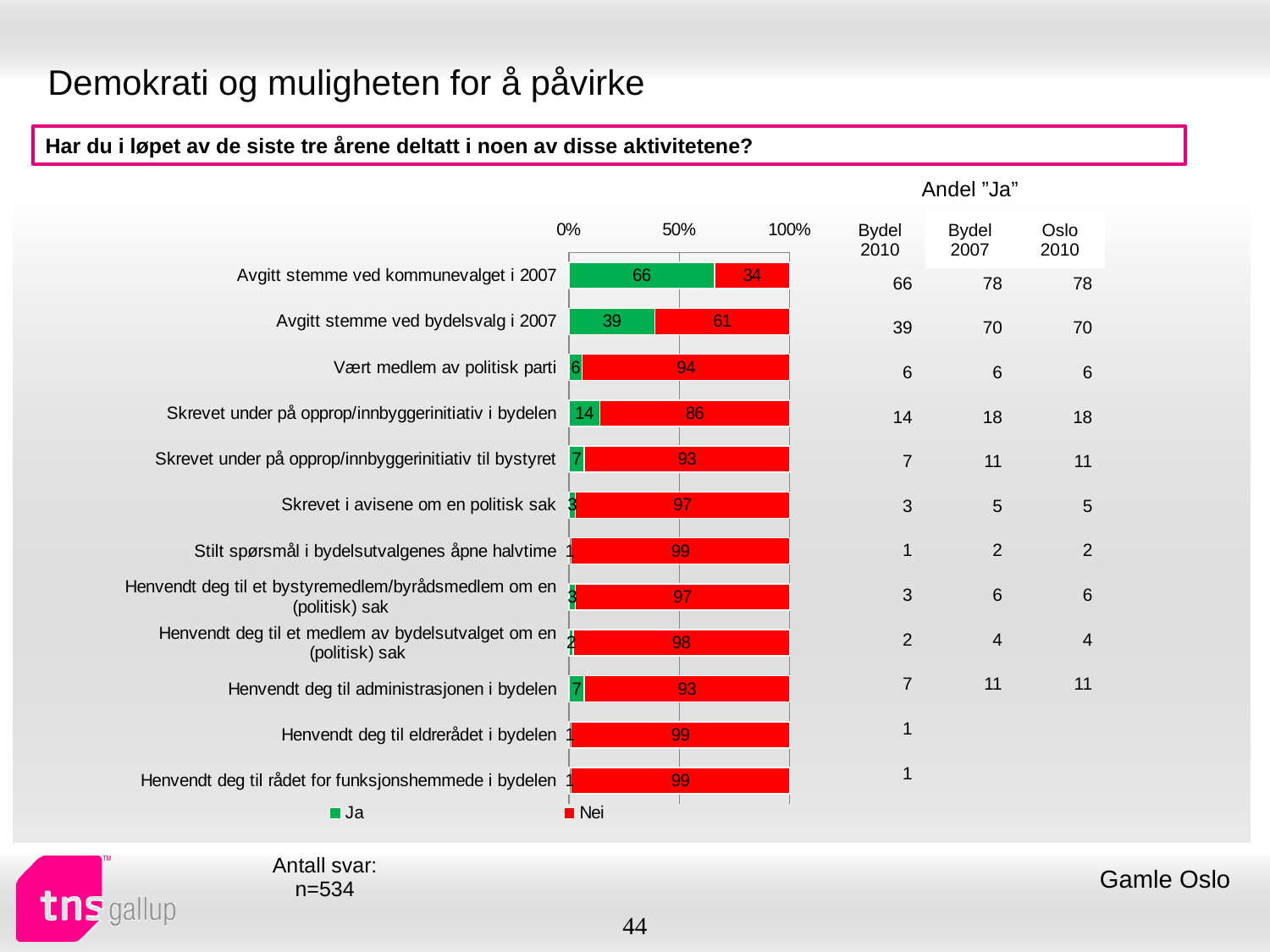
What is the difference between the "Ja" values for "Avgitt stemme ved kommunevalget i 2007" and "Avgitt stemme ved bydelsvalg i 2007"? 27 Which is larger: the "Ja" value for "Skrevet under på opprop/innbyggerinitiativ i bydelen" or for "Henvendt deg til administrasjonen i bydelen"? Skrevet under på opprop/innbyggerinitiativ i bydelen Which category has the highest "Nei" value? Stilt spørsmål i bydelsutvalgenes åpne halvtime, Henvendt deg til eldrerådet i bydelen, and Henvendt deg til rådet for funksjonshemmede i bydelen (all 99) What is the total of the stacked bar for "Skrevet under på opprop/innbyggerinitiativ til bystyret"? 100 How many series does the legend list? 2 What is the "Ja" value for "Avgitt stemme ved kommunevalget i 2007"? 66 What kind of chart is shown on the slide? Stacked bar chart Which category has the highest "Ja" value? Avgitt stemme ved kommunevalget i 2007 What is the "Ja" value for "Skrevet under på opprop/innbyggerinitiativ i bydelen"? 14 How many categories are shown in the chart? 12 What is the "Nei" value for "Vært medlem av politisk parti"? 94 What is the "Nei" value for "Avgitt stemme ved bydelsvalg i 2007"? 61